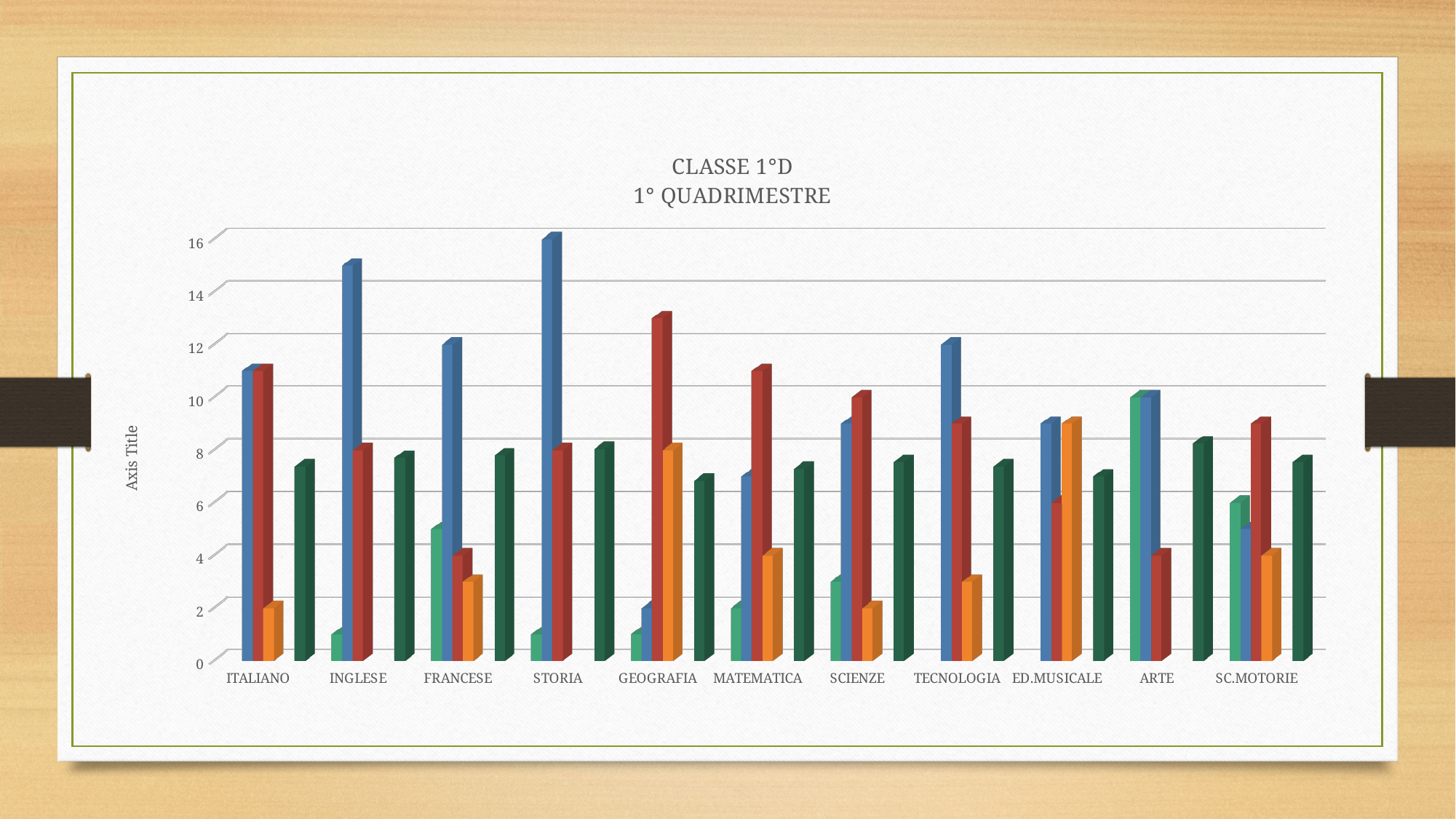
Is the orange bar for ITALIANO greater or less than 4? less What label is shown on the vertical axis of the chart? Axis Title Is the blue bar for INGLESE greater or less than 14? greater Which category has the tallest blue bar? STORIA Is the dark green bar for ARTE greater or less than 6? greater For GEOGRAFIA, which is larger: the red bar or the blue bar? red bar For FRANCESE, which is larger: the blue bar or the red bar? blue bar What is the title of the chart? CLASSE 1°D 1° QUADRIMESTRE How many subject categories are shown along the x axis of the chart? 11 For SC.MOTORIE, which is larger: the red bar or the orange bar? red bar What kind of chart is shown on the slide? bar chart